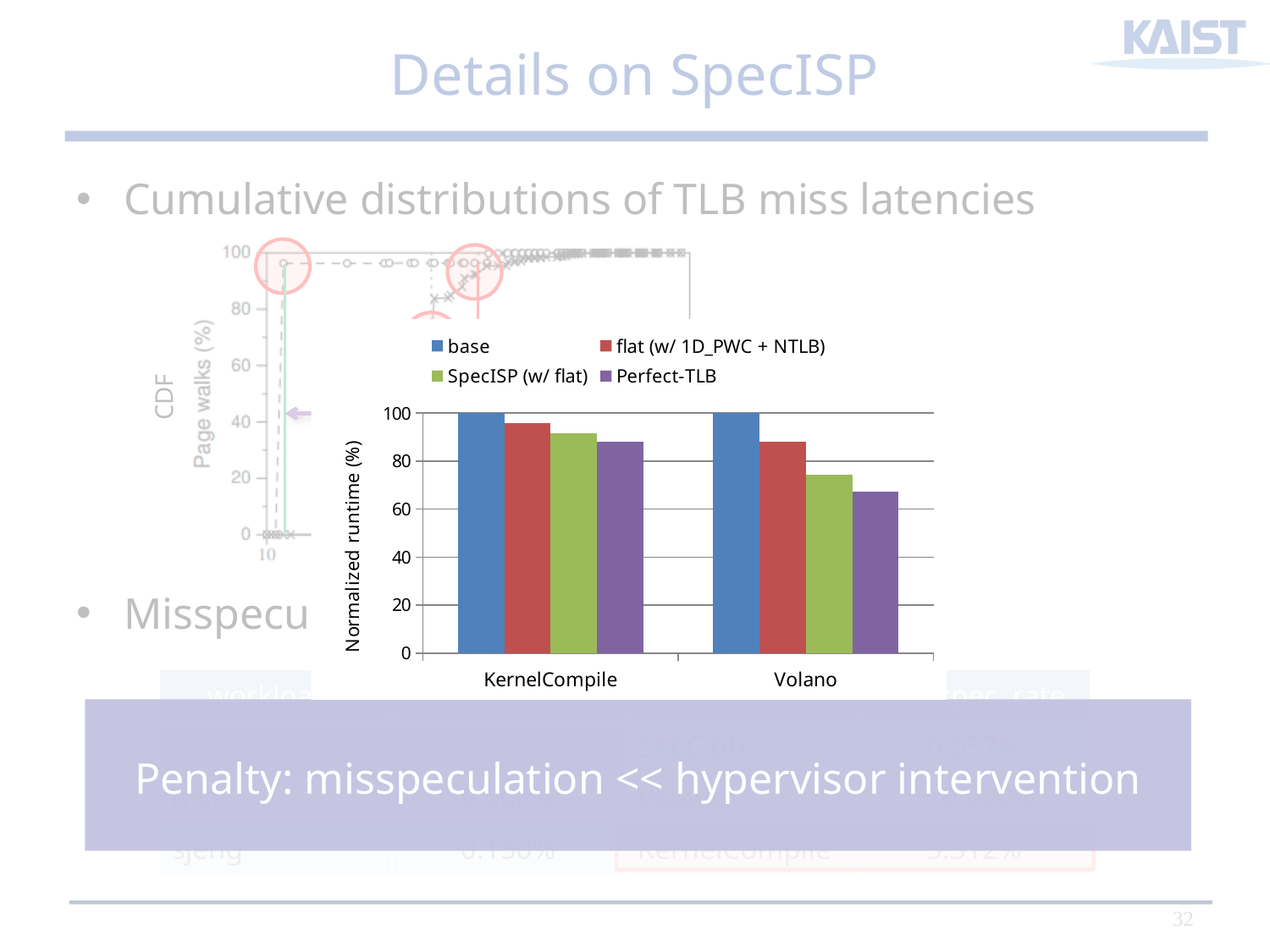
How many workload categories are shown on the x axis of the bar chart? 2 Is the value for flat (w/ 1D_PWC + NTLB) on KernelCompile greater or less than 80? greater Is the value for Perfect-TLB on Volano greater or less than 80? less What kind of chart is shown on the slide? bar chart Which series has the lowest normalized runtime for Volano? Perfect-TLB What is the normalized runtime of base for KernelCompile? 100 For Volano, do the bars rise or fall going from base to Perfect-TLB in legend order? fall What is the label of the y axis of the bar chart? Normalized runtime (%) Which series has the highest normalized runtime for Volano? base How many series does the legend of the bar chart list? 4 Is the value for SpecISP (w/ flat) on Volano greater or less than 60? greater For SpecISP (w/ flat), which workload has the larger normalized runtime, KernelCompile or Volano? KernelCompile